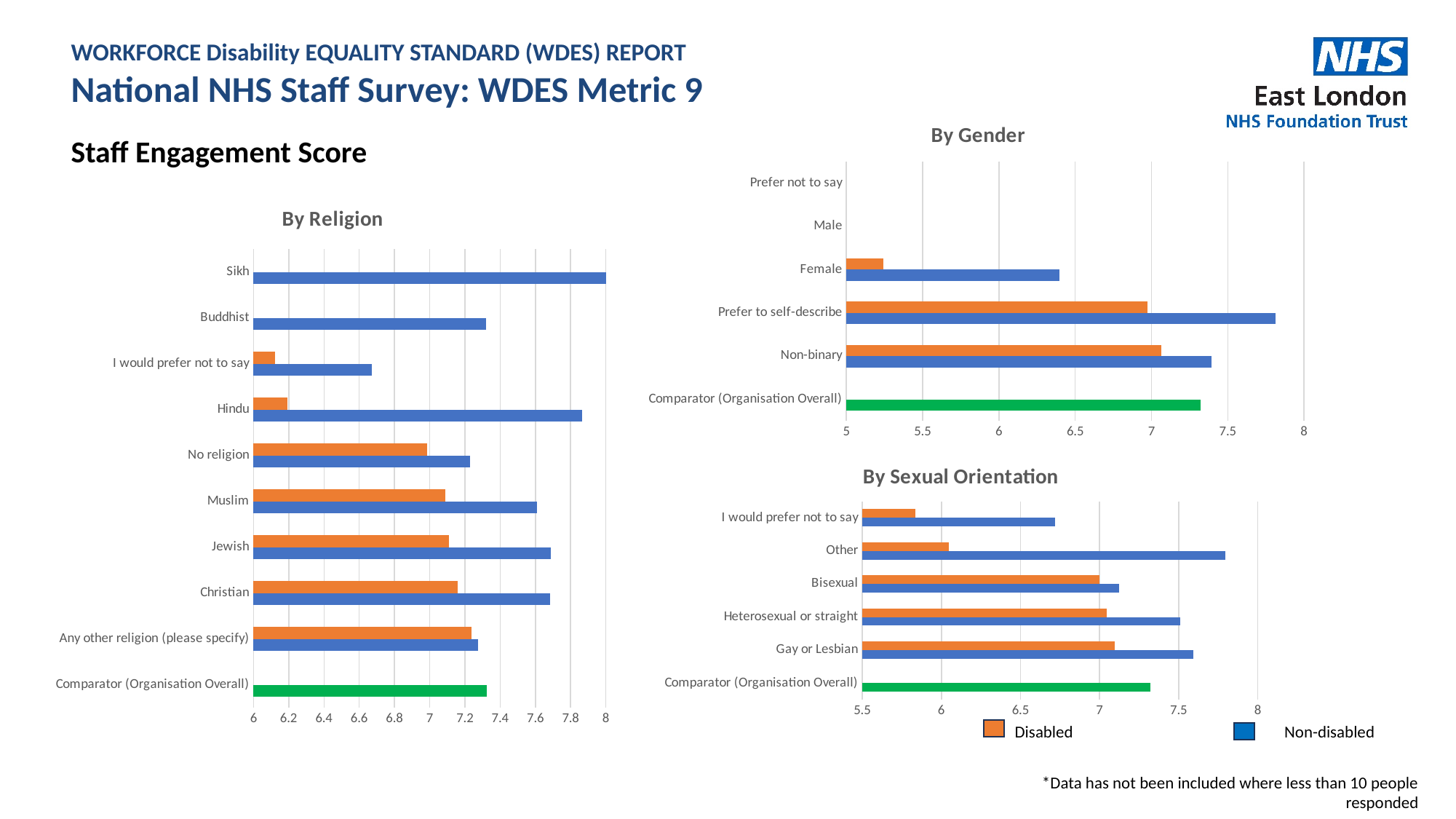
What kind of chart is the 'By Religion' chart? bar chart In the 'By Religion' chart, is the Non-disabled value for Hindu greater or less than 7.6? greater In the 'By Gender' chart, is the Non-disabled value for Prefer to self-describe greater or less than 7.5? greater In the 'By Religion' chart, is the Disabled value for Hindu greater or less than 6.4? less In the 'By Religion' chart, which is larger for Muslim: the Disabled value or the Non-disabled value? Non-disabled In the 'By Gender' chart, which category has the lowest Disabled value? Female In the 'By Sexual Orientation' chart, which category has the highest Non-disabled value? Other In the 'By Religion' chart, which category has the highest Non-disabled value? Sikh How many series does the legend at the bottom of the slide list? 2 What colour is the Comparator (Organisation Overall) bar in the 'By Sexual Orientation' chart? green